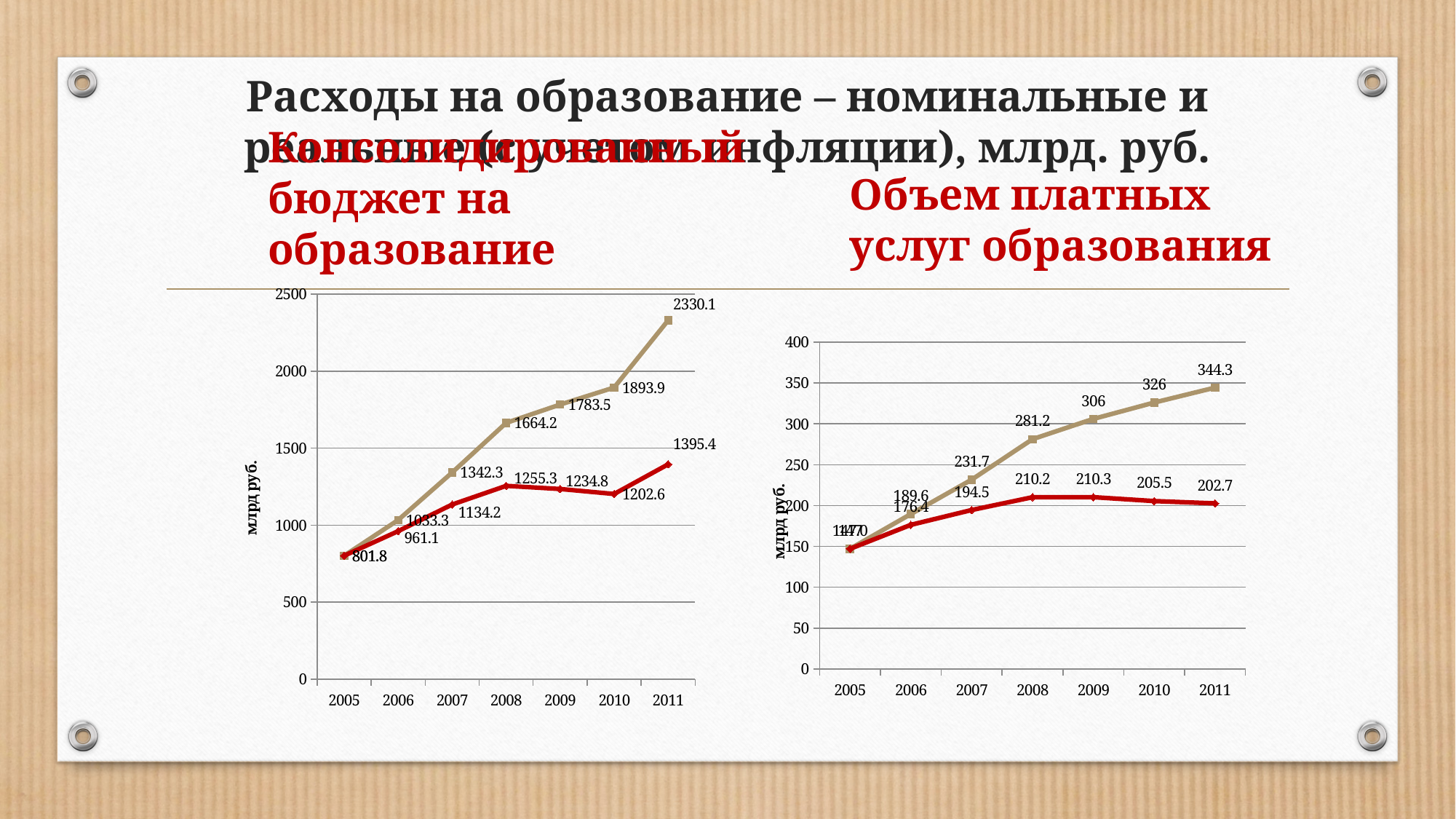
What is the y-axis label on the left chart? млрд руб. In the left chart, what is the difference between the tan line and the red line in 2011? 934.7 In the left chart, which year has the highest value on the red line? 2011 In the left chart, what is the value of the tan (upper) line in 2011? 2330.1 In the right chart, does the tan line rise or fall from 2005 to 2011? rise In the left chart, what is the value of the red (lower) line in 2009? 1234.8 In the right chart, what is the value of the red (lower) line in 2010? 205.5 In the left chart, how many years are shown on the x axis? 7 What type of chart is shown on the left side of the slide? line chart In the right chart, which year has the highest value on the red line? 2009 In the right chart, what is the value of the tan (upper) line in 2008? 281.2 In the right chart, what is the difference between the tan line and the red line in 2011? 141.6